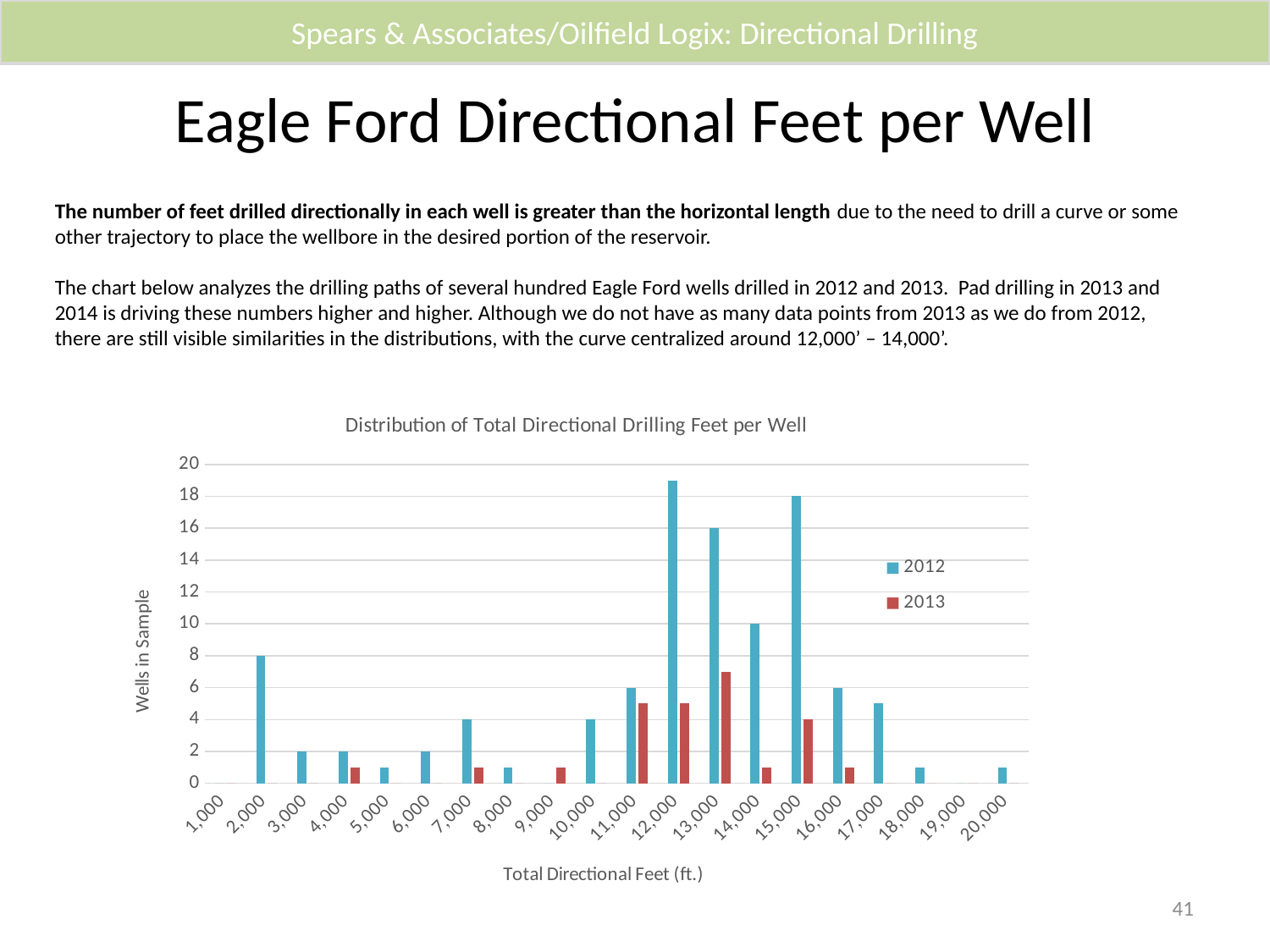
What is the title of the chart? Distribution of Total Directional Drilling Feet per Well What type of chart is shown on the slide? Bar chart How many categories are shown on the x axis? 20 Is the 2013 value at 13,000 feet greater or less than 6? greater What is the 2013 value at 15,000 feet? 4 How many series does the legend list? 2 At which category is the 2013 series highest? 13,000 What is the 2012 value at 2,000 feet? 8 What is the 2012 value at 15,000 feet? 18 Which is larger for 2012: the value at 13,000 feet or at 14,000 feet? 13,000 What is the difference between the 2012 values at 15,000 feet and 13,000 feet? 2 Is the 2012 value at 12,000 feet greater or less than 10? greater